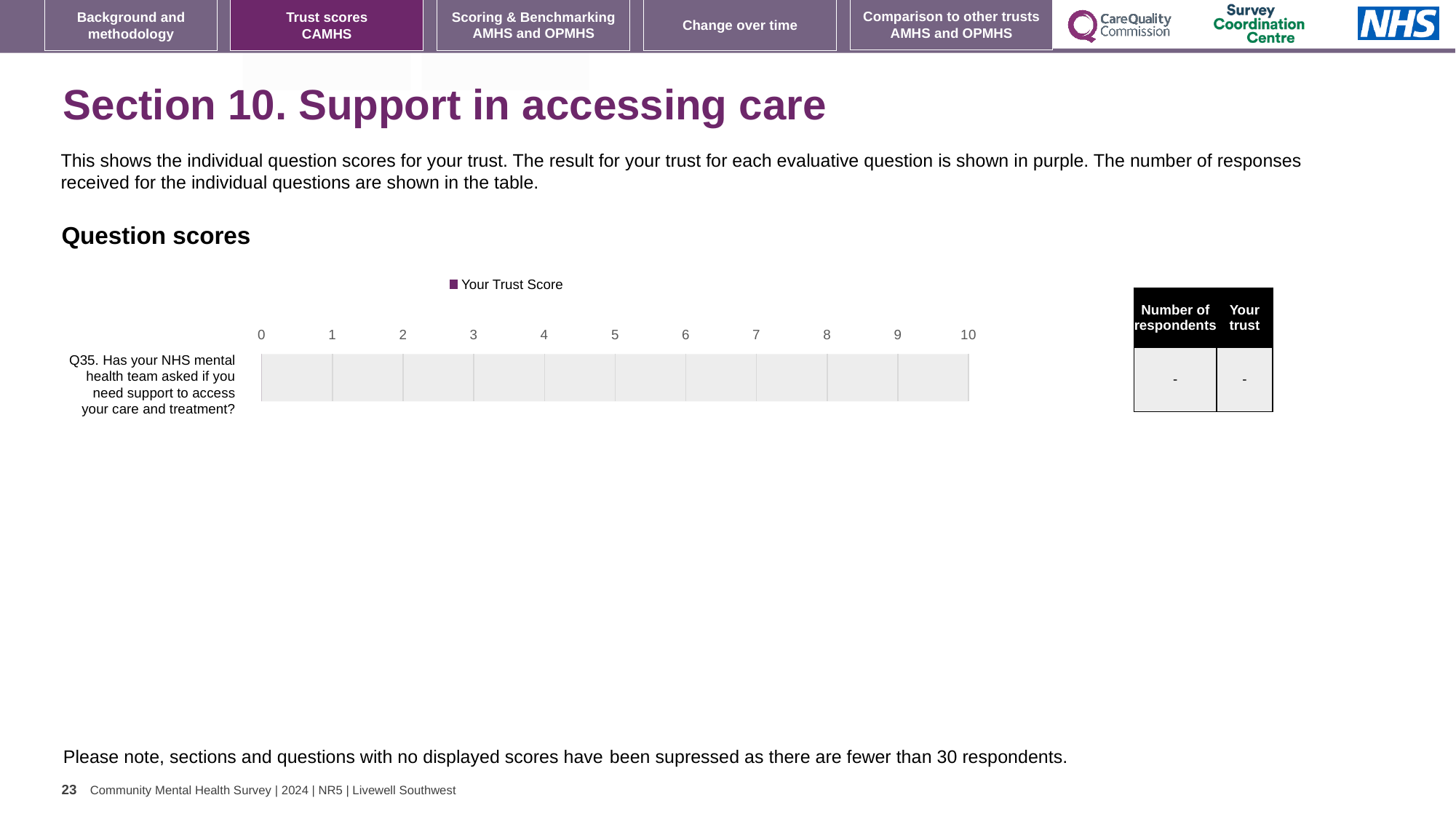
How many series does the chart legend list? 1 How many questions (categories) are listed on the chart's vertical axis? 1 What is the name of the series shown in the chart legend? Your Trust Score Which question is plotted on the chart? Q35. Has your NHS mental health team asked if you need support to access your care and treatment? What kind of chart is shown under "Question scores"? bar chart What is the maximum value shown on the chart's horizontal axis? 10